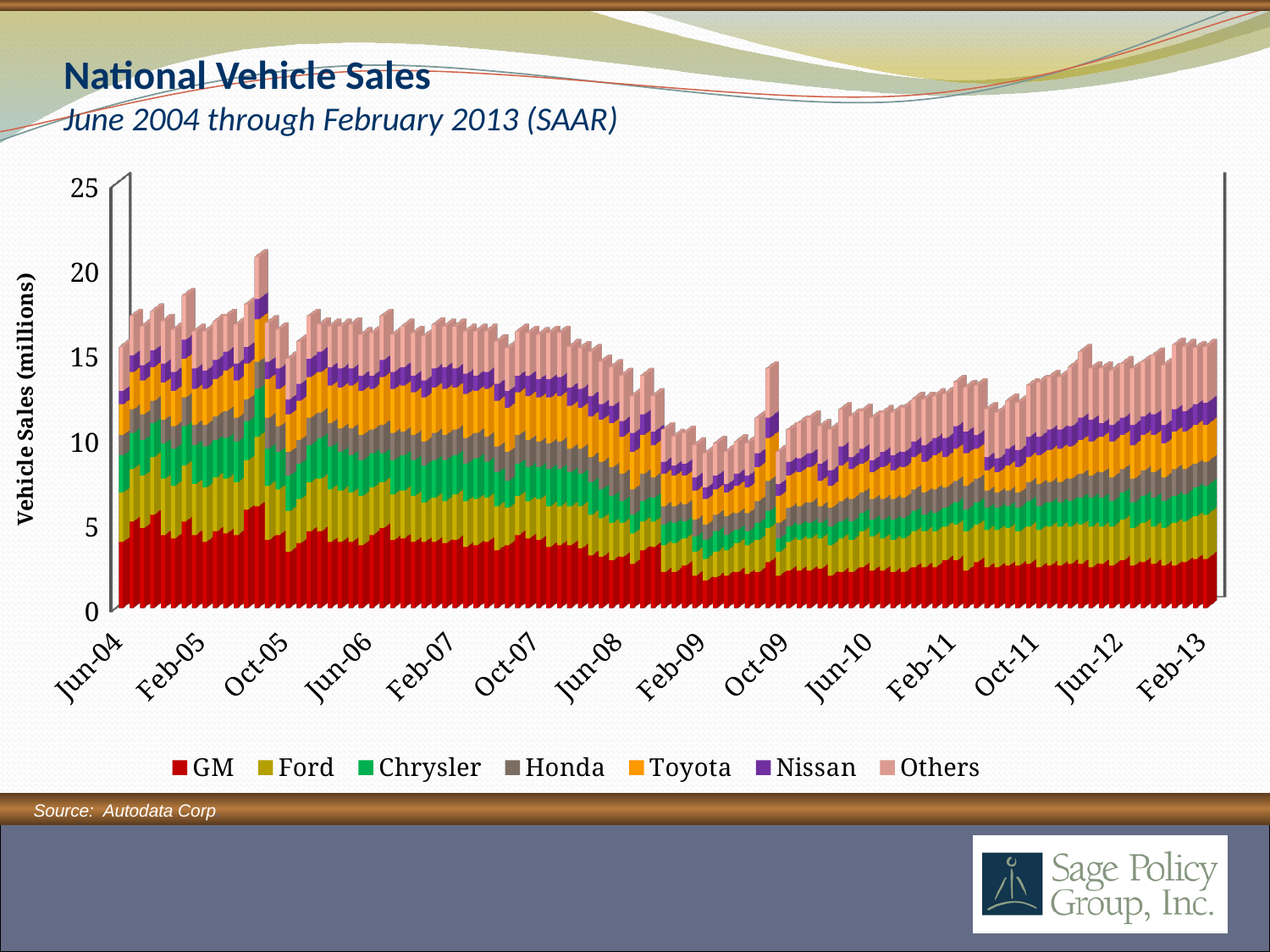
Do total vehicle sales rise or fall between Jun-08 and Feb-09? fall What kind of chart is shown on the slide? Stacked bar chart Is the total vehicle sales value for Feb-13 greater or less than 10? greater Which series is plotted at the bottom of each stacked bar? GM Around which x-axis label does the tallest stacked bar occur? Oct-05 Do total vehicle sales rise or fall between Feb-09 and Feb-13? rise Is the total vehicle sales value for Feb-09 greater or less than 15? less What is the label on the vertical axis? Vehicle Sales (millions) How many series does the legend list? 7 What is the title of the chart? National Vehicle Sales How many labels are shown on the x axis? 14